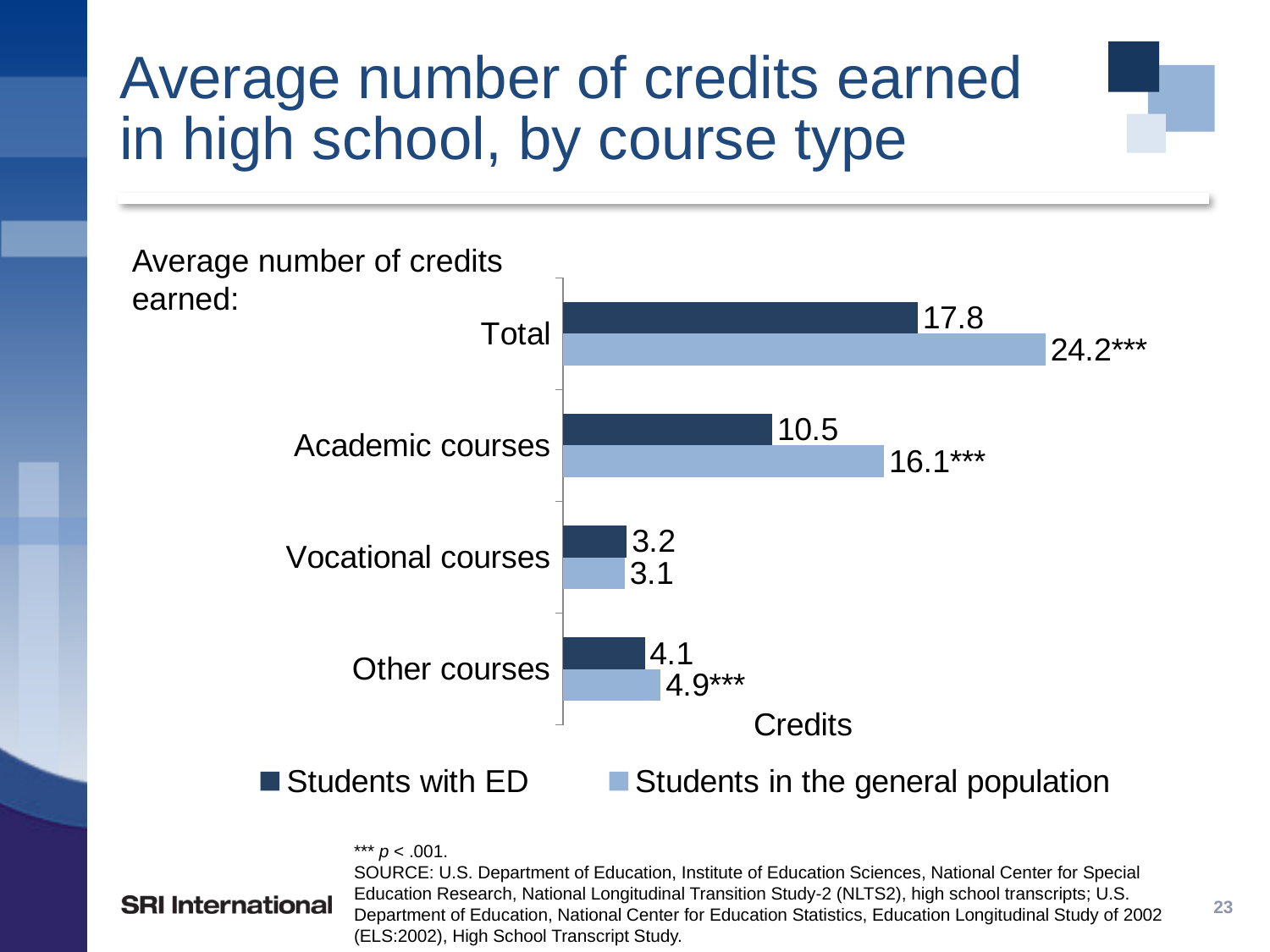
How many course type categories are shown on the chart? 4 How many series does the legend list? 2 What is the average number of credits earned in Other courses for Students in the general population? 4.9 What is the difference between Students in the general population and Students with ED in Academic courses credits? 5.6 Which group earned more credits in Academic courses, Students with ED or Students in the general population? Students in the general population What is the average number of credits earned in Academic courses for Students in the general population? 16.1 Which category has the highest average number of credits earned for Students with ED? Total What kind of chart is shown on the slide? Bar chart What is the difference between Students in the general population and Students with ED in Total credits earned? 6.4 Which course type has the lowest average number of credits earned for Students in the general population? Vocational courses What is the average number of credits earned in Vocational courses for Students with ED? 3.2 What is the average number of credits earned in Total for Students with ED? 17.8